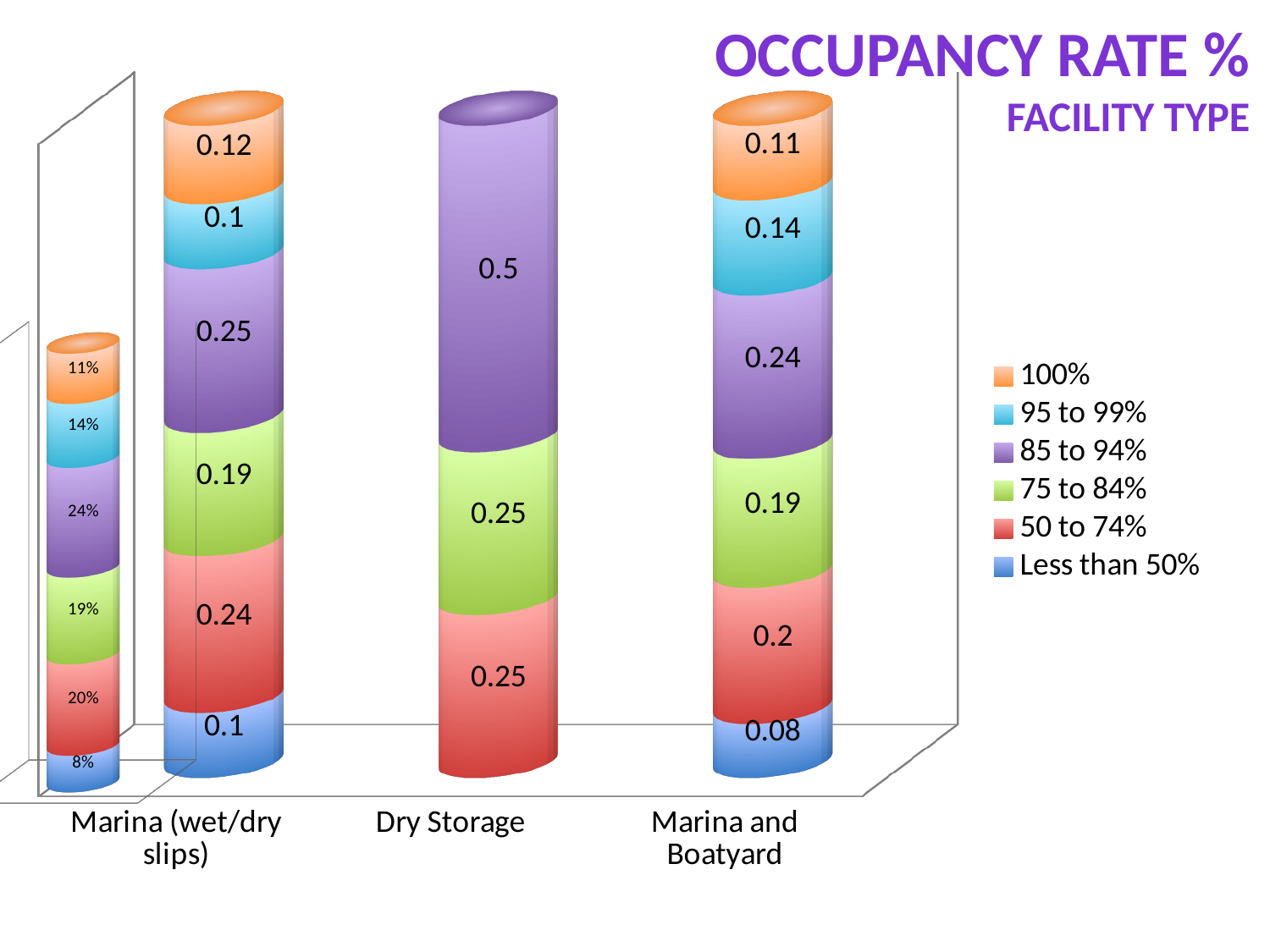
What is the title of the chart on the slide? OCCUPANCY RATE % FACILITY TYPE In the large stacked bar chart, which is larger: the 95 to 99% value for Marina (wet/dry slips) or for Marina and Boatyard? Marina and Boatyard In the large stacked bar chart, what is the value of the 100% segment for Marina (wet/dry slips)? 0.12 What kind of chart is the large chart on the slide? Stacked bar chart How many series does the legend of the chart list? 6 In the large stacked bar chart, what is the value of the Less than 50% segment for Marina and Boatyard? 0.08 In the large stacked bar chart, which facility type has the smallest Less than 50% segment among those with a labelled value? Marina and Boatyard In the large stacked bar chart, what is the value of the 85 to 94% segment for Dry Storage? 0.5 How many facility types are shown on the x axis of the large stacked bar chart? 3 In the large stacked bar chart, what is the difference between the 50 to 74% values for Dry Storage and Marina and Boatyard? 0.05 In the large stacked bar chart, which facility type has the largest 85 to 94% segment? Dry Storage In the large stacked bar chart, what is the value of the 50 to 74% segment for Marina (wet/dry slips)? 0.24